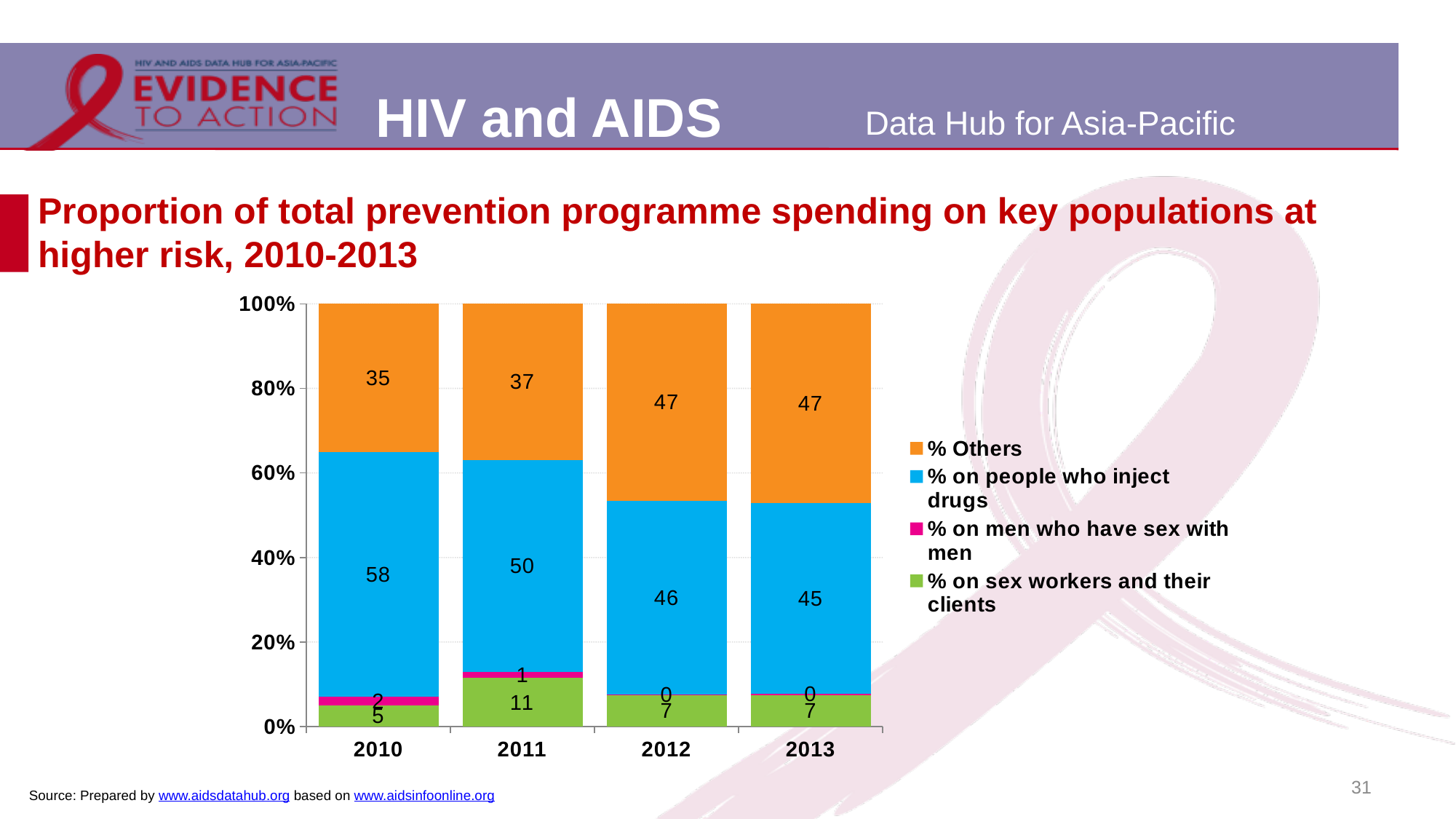
What is the value for % Others in 2013? 47 Does the value for % on people who inject drugs rise or fall from 2010 to 2013? Fall What type of chart is shown on the slide? Stacked bar chart In which year is the value for % on people who inject drugs highest? 2010 What is the value for % on people who inject drugs in 2010? 58 What is the value for % on men who have sex with men in 2012? 0 How many years are shown on the x axis? 4 What is the value for % on sex workers and their clients in 2011? 11 In which year is the value for % Others lowest? 2010 Which is larger in 2011: % on people who inject drugs or % Others? % on people who inject drugs What is the difference between the % Others values in 2012 and 2010? 12 How many series does the legend list? 4